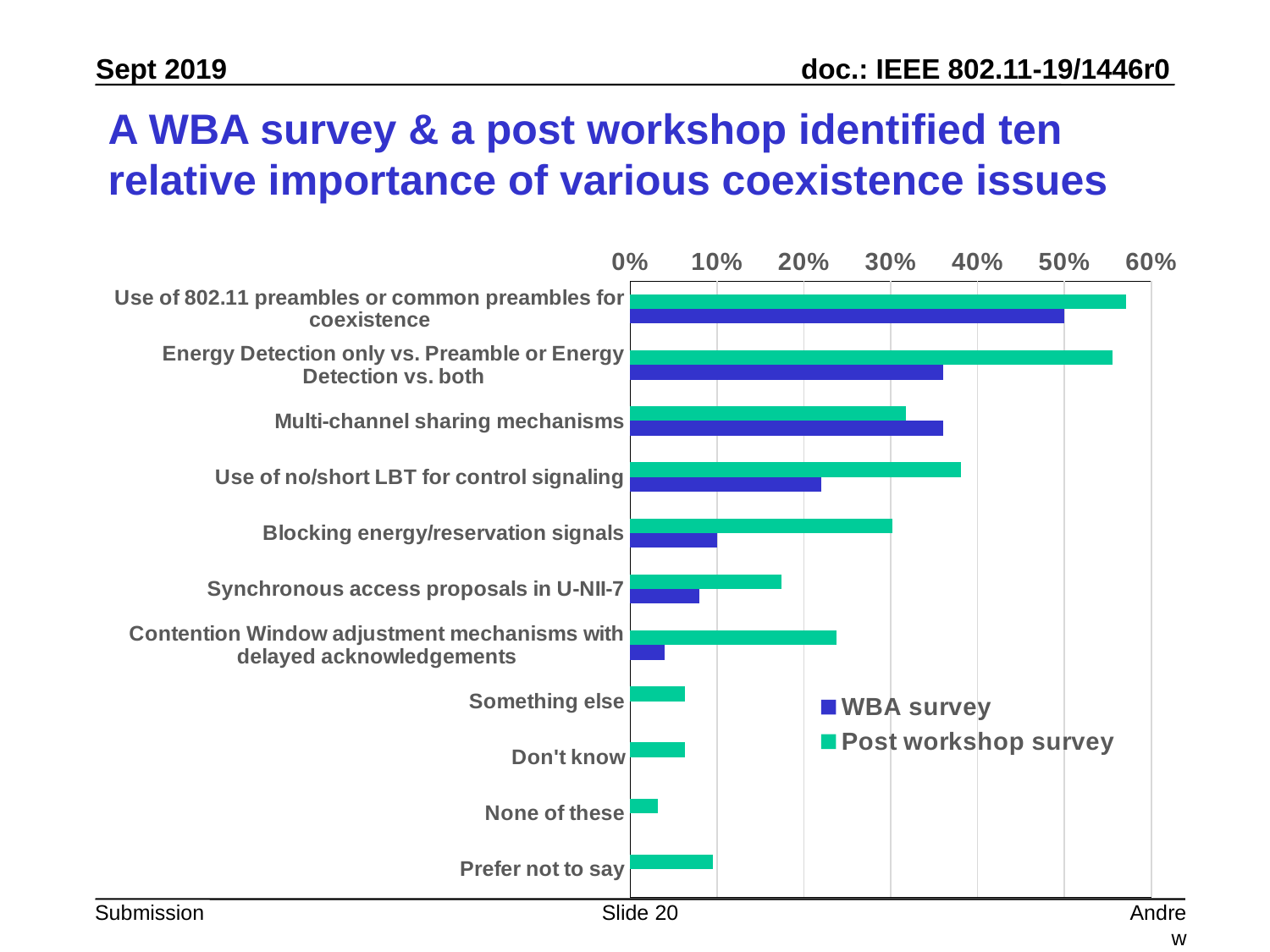
Is the WBA survey value for 'Contention Window adjustment mechanisms with delayed acknowledgements' greater or less than 10%? less What kind of chart is shown on the slide? bar chart Which category has the highest value in the WBA survey series? Use of 802.11 preambles or common preambles for coexistence Which category has the lowest value in the Post workshop survey series? None of these Is the Post workshop survey value for 'Prefer not to say' greater or less than 20%? less For 'Energy Detection only vs. Preamble or Energy Detection vs. both', which series has the larger value, WBA survey or Post workshop survey? Post workshop survey Is the Post workshop survey value for 'Use of no/short LBT for control signaling' greater or less than 30%? greater Which series is shown in green in the legend? Post workshop survey How many categories are plotted on the chart? 11 How many series does the legend list? 2 For 'Multi-channel sharing mechanisms', which series has the larger value, WBA survey or Post workshop survey? WBA survey Which category has the highest value in the Post workshop survey series? Use of 802.11 preambles or common preambles for coexistence